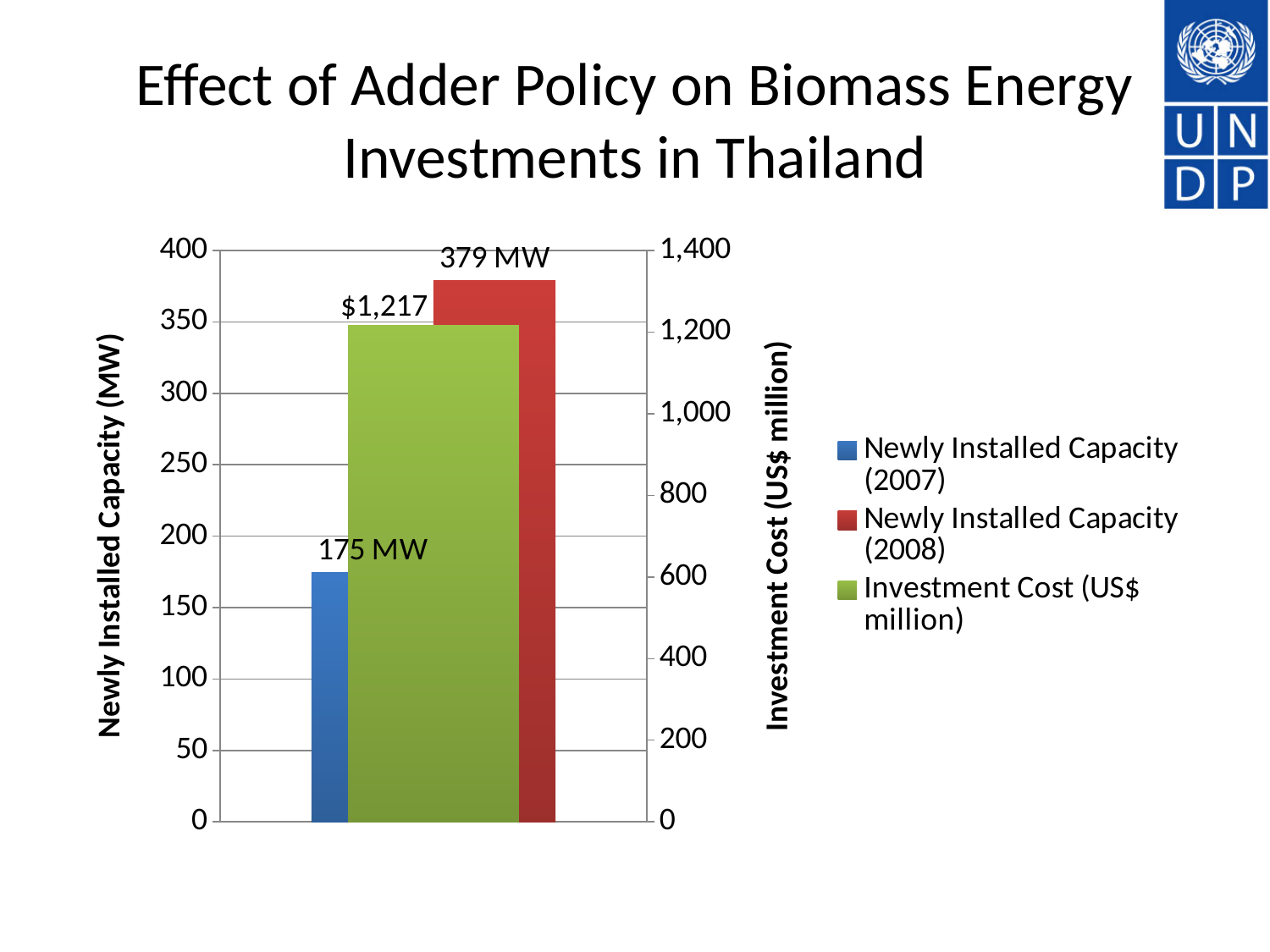
What is the value shown for Investment Cost (US$ million)? $1,217 What is the value shown for Newly Installed Capacity (2007)? 175 MW How many series does the legend list? 3 Is the value for Newly Installed Capacity (2008) greater or less than 350 MW? greater What kind of chart is shown on the slide? Bar chart Is the value for Newly Installed Capacity (2007) greater or less than 200 MW? less What is the value shown for Newly Installed Capacity (2008)? 379 MW What is the label of the right-hand vertical axis? Investment Cost (US$ million) Which series has the higher newly installed capacity, 2007 or 2008? Newly Installed Capacity (2008) By how many MW did newly installed capacity in 2008 exceed that of 2007? 204 MW What colour is the bar for Investment Cost (US$ million)? Green Is the Investment Cost greater or less than 1,000 US$ million? greater